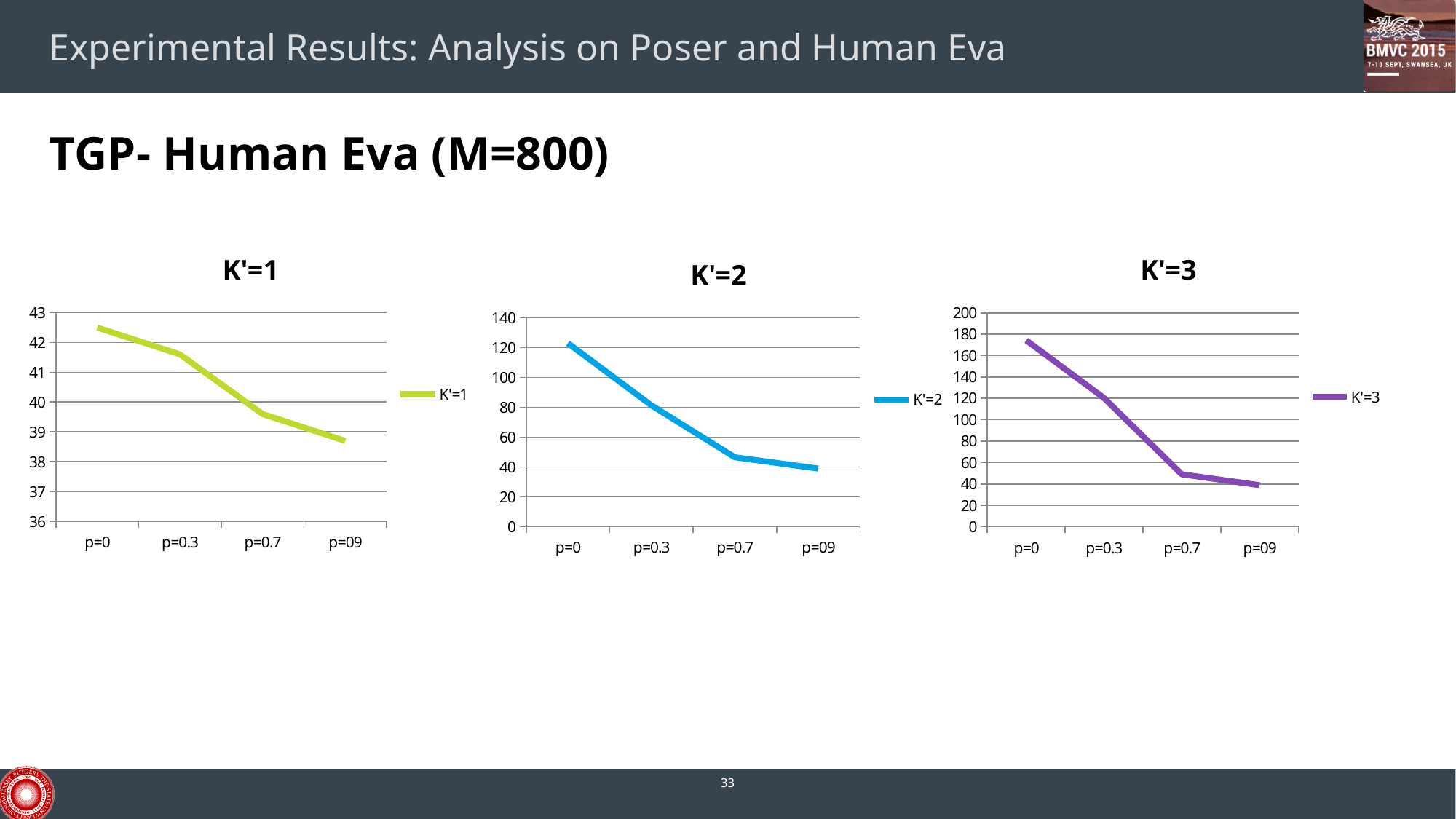
How many points are plotted on the K'=2 chart? 4 What colour is the line in the K'=3 chart? purple In the K'=1 chart, is the value for p=09 greater or less than 39? less In the K'=2 chart, which is larger, the value for p=0.3 or the value for p=0.7? p=0.3 In the K'=3 chart, which p value has the highest plotted value? p=0 How many series does the legend of the K'=3 chart list? 1 What kind of chart is the K'=1 chart? line chart In the K'=3 chart, is the value for p=09 greater or less than 60? less In the K'=1 chart, is the value for p=0 greater or less than 42? greater In the K'=1 chart, do the values rise or fall as p increases from p=0 to p=09? fall In the K'=2 chart, which p value has the lowest plotted value? p=09